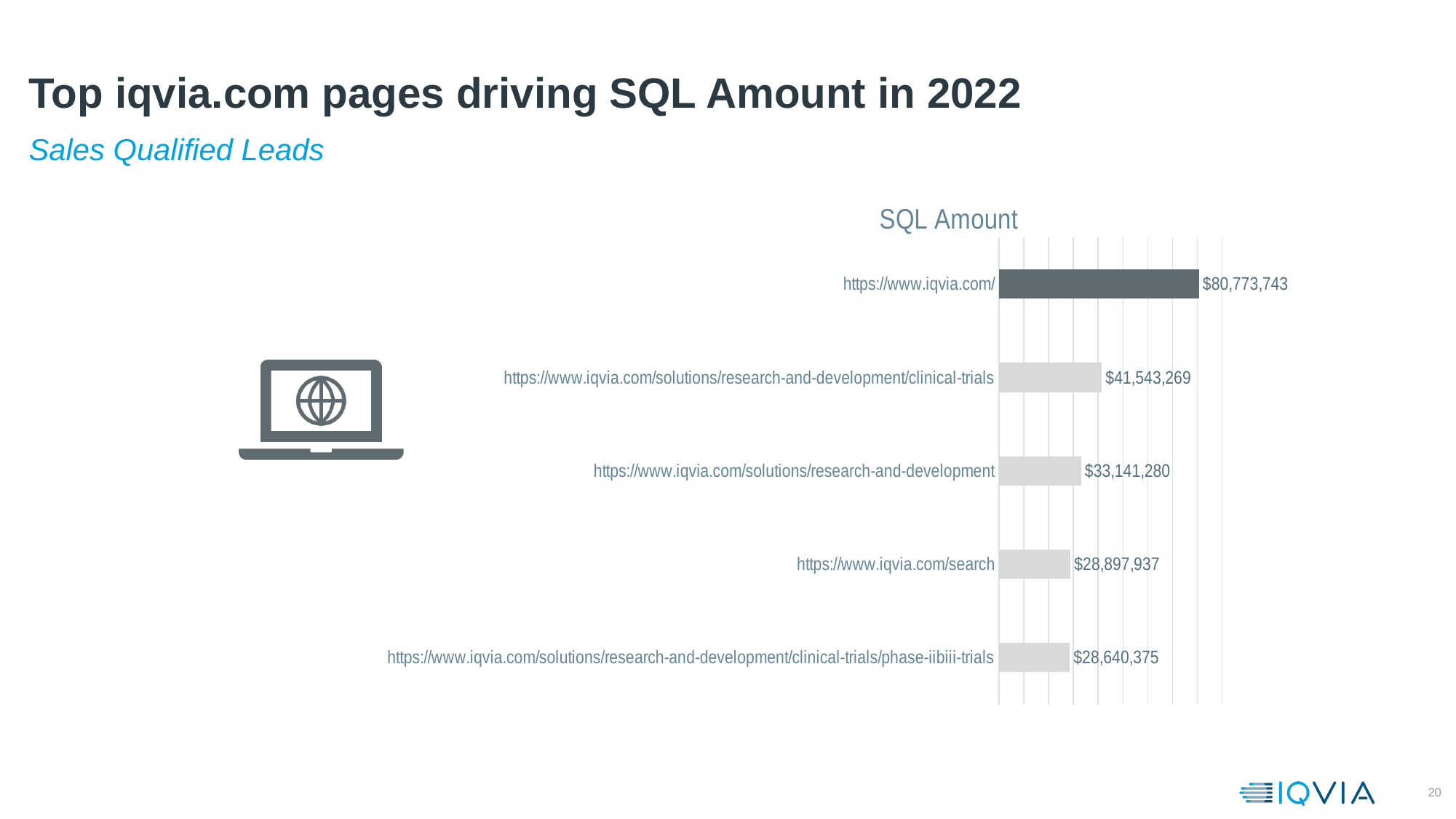
What kind of chart is shown on the slide? Bar chart Which page has the lowest SQL Amount? https://www.iqvia.com/solutions/research-and-development/clinical-trials/phase-iibiii-trials What is the difference in SQL Amount between https://www.iqvia.com/ and https://www.iqvia.com/solutions/research-and-development/clinical-trials? $39,230,474 What is the title of the chart? SQL Amount Which page has the highest SQL Amount? https://www.iqvia.com/ What is the difference in SQL Amount between https://www.iqvia.com/solutions/research-and-development/clinical-trials and https://www.iqvia.com/solutions/research-and-development? $8,401,989 What is the SQL Amount for https://www.iqvia.com/solutions/research-and-development/clinical-trials/phase-iibiii-trials? $28,640,375 What is the SQL Amount for https://www.iqvia.com/search? $28,897,937 Which has a larger SQL Amount: https://www.iqvia.com/solutions/research-and-development or https://www.iqvia.com/search? https://www.iqvia.com/solutions/research-and-development What is the SQL Amount for https://www.iqvia.com/solutions/research-and-development/clinical-trials? $41,543,269 How many pages are shown in the chart? 5 What is the SQL Amount for https://www.iqvia.com/? $80,773,743